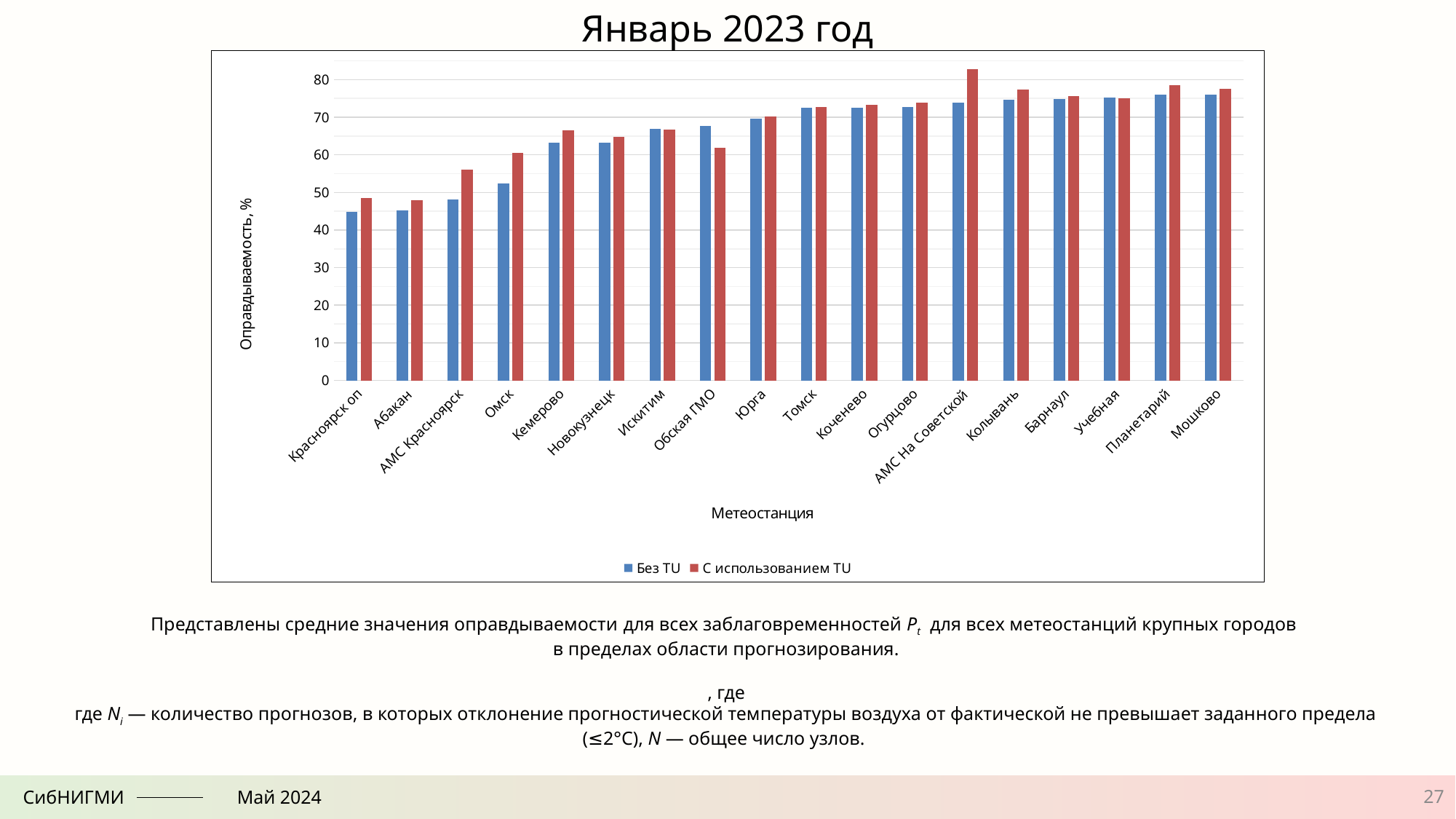
Is the value for 'С использованием TU' at АМС На Советской greater or less than 80? greater Is the value for 'Без TU' at Томск greater or less than 70? greater How many series does the legend list? 2 Is the value for 'С использованием TU' at АМС Красноярск greater or less than 50? greater What kind of chart is shown on the slide? bar chart How many weather stations (categories) are shown on the x axis? 18 At Омск, which series has the larger value: 'Без TU' or 'С использованием TU'? С использованием TU At Обская ГМО, which series has the larger value: 'Без TU' or 'С использованием TU'? Без TU Which station has the highest value for the series 'С использованием TU'? АМС На Советской What is the title of the chart? Январь 2023 год